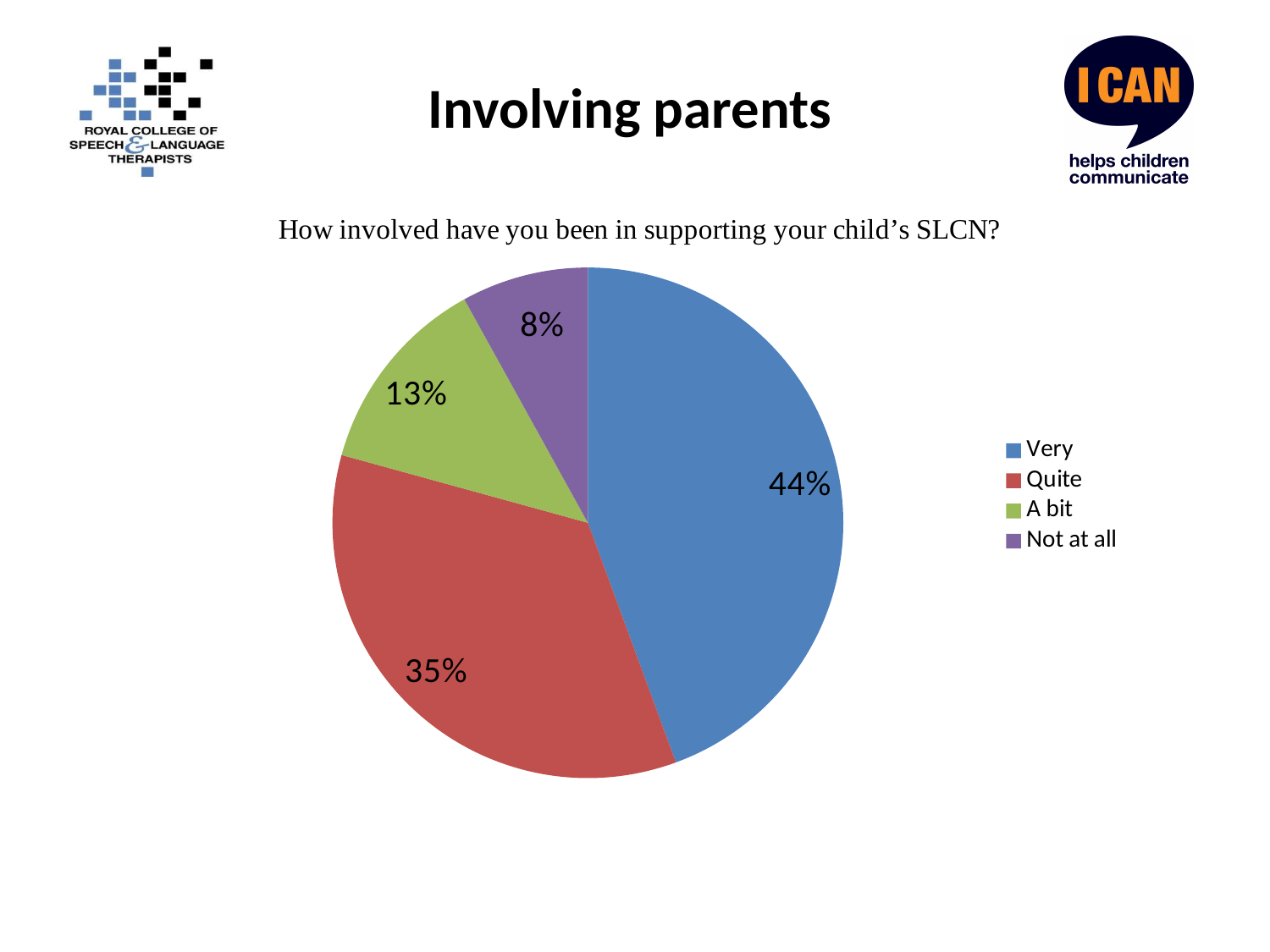
What question is the pie chart answering, as written above it? How involved have you been in supporting your child's SLCN? Which is larger, the share for 'Quite' or the share for 'A bit'? Quite What is the difference in percentage points between 'Very' and 'Quite'? 9 What percentage of parents said they were involved 'A bit'? 13% Which response has the smallest share of the pie? Not at all How many categories does the legend list? 4 What is the difference in percentage points between 'A bit' and 'Not at all'? 5 What percentage of parents said they were 'Quite' involved? 35% What percentage of parents said they were 'Very' involved? 44% What kind of chart is shown on the slide? pie chart Which response has the largest share of the pie? Very What percentage of parents said they were 'Not at all' involved? 8%